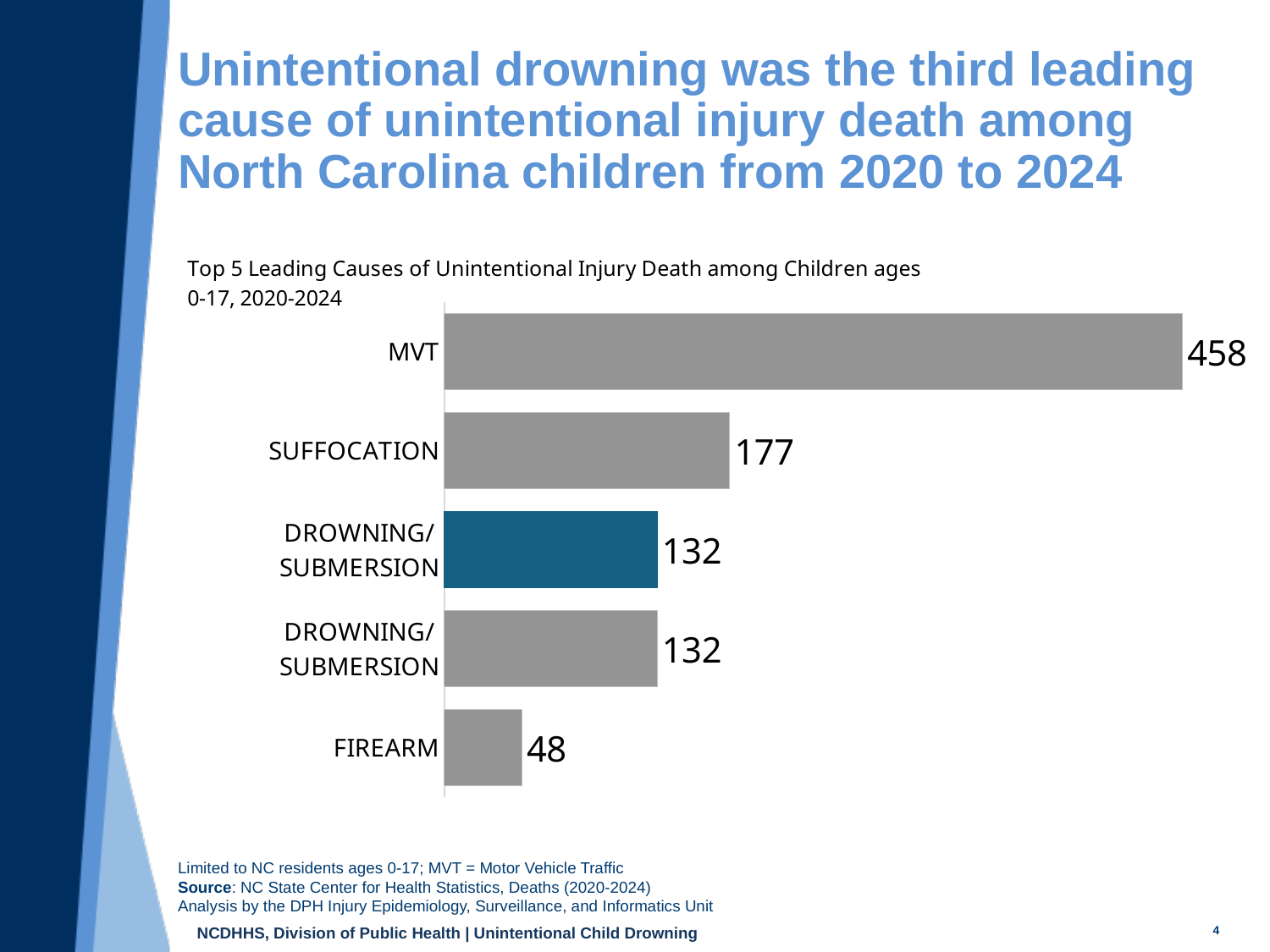
What is the value for SUFFOCATION? 177 Which category has the lowest value? FIREARM What is the value for MVT? 458 What kind of chart is shown on the slide? Bar chart What is the value for FIREARM? 48 How many bars are shown in the chart? 5 What is the difference between the values for MVT and SUFFOCATION? 281 Which is larger, the value for SUFFOCATION or the value for FIREARM? SUFFOCATION What is the difference between the values for SUFFOCATION and DROWNING/SUBMERSION? 45 Which category's bar is highlighted in blue rather than grey? DROWNING/SUBMERSION What is the value for DROWNING/SUBMERSION? 132 Which category has the highest value? MVT